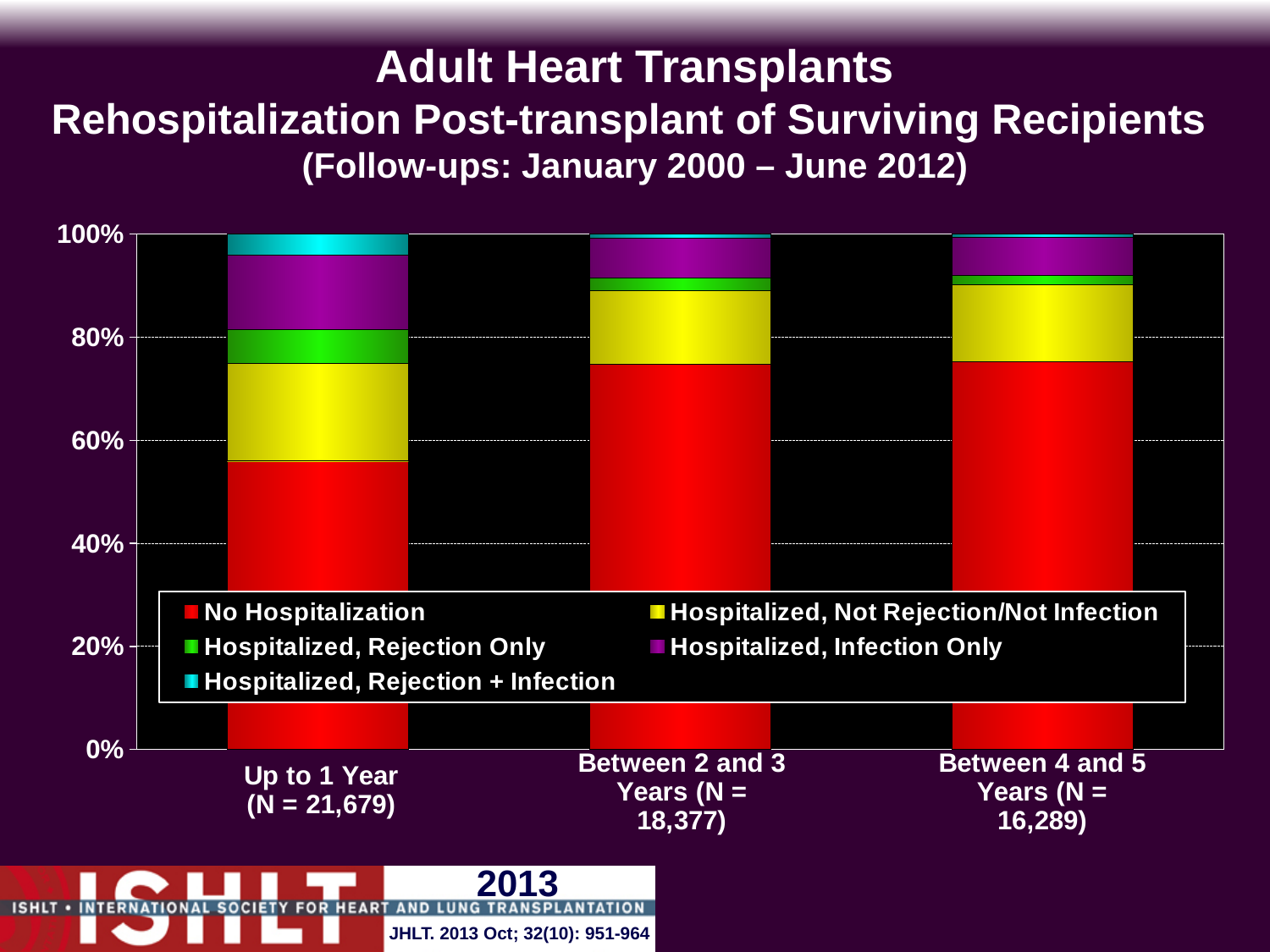
Which follow-up category has the largest Hospitalized, Not Rejection/Not Infection segment? Up to 1 Year Is the No Hospitalization share for Between 4 and 5 Years greater or less than 80%? less What is the N for the Between 2 and 3 Years category? 18,377 How many follow-up time categories are shown on the x axis? 3 What is the N for the Up to 1 Year category? 21,679 Is the Hospitalized, Rejection Only segment larger for Up to 1 Year or for Between 4 and 5 Years? Up to 1 Year Is the No Hospitalization share for Between 2 and 3 Years greater or less than 60%? greater Is the No Hospitalization share for Up to 1 Year greater or less than 60%? less Which colour represents No Hospitalization in the legend? Red How many series does the legend list? 5 What kind of chart is shown on the slide? Stacked bar chart Which follow-up category has the smallest No Hospitalization share? Up to 1 Year